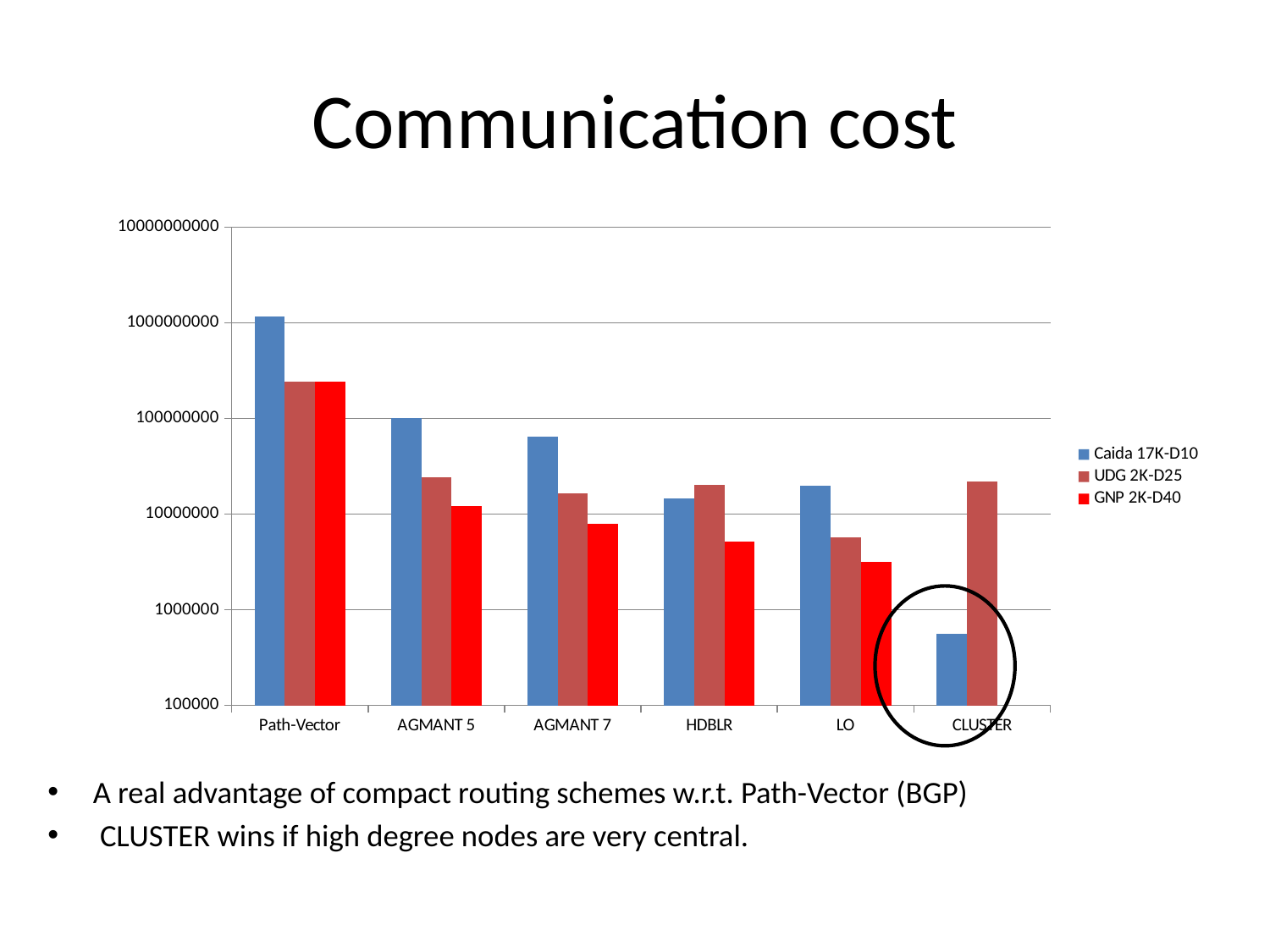
Is the Caida 17K-D10 value for Path-Vector greater or less than 1000000000? greater For CLUSTER, which is larger: the Caida 17K-D10 value or the UDG 2K-D25 value? UDG 2K-D25 For HDBLR, which is larger: the UDG 2K-D25 value or the GNP 2K-D40 value? UDG 2K-D25 Is the GNP 2K-D40 value for LO greater or less than 10000000? less How many series does the chart's legend list? 3 How many categories are shown on the x axis of the chart? 6 For the Caida 17K-D10 series, which category has the lowest value? CLUSTER For the Caida 17K-D10 series, which category has the highest value? Path-Vector For the UDG 2K-D25 series, which category has the highest value? Path-Vector What kind of chart is shown on the slide? bar chart Is the Caida 17K-D10 value for CLUSTER greater or less than 1000000? less Which series has no bar shown for the CLUSTER category? GNP 2K-D40